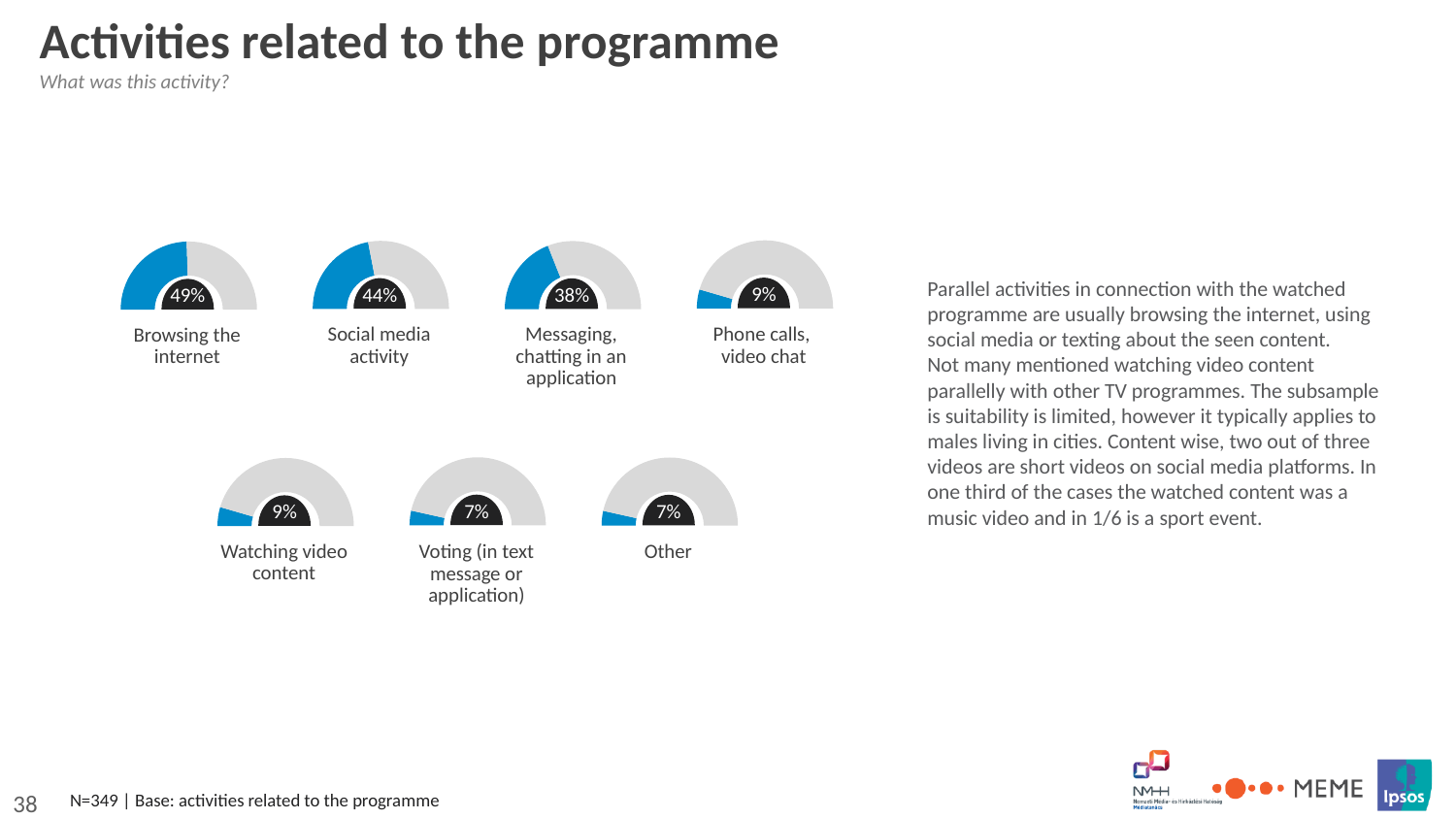
What is the difference in percentage points between Browsing the internet and Social media activity? 5 What colour is used for the filled portion of each gauge? Blue What percentage is shown for Messaging, chatting in an application? 38% What percentage is shown for Browsing the internet? 49% What kind of chart is used to show each activity's percentage? Gauge (semi-circular doughnut) chart What percentage is shown for Voting (in text message or application)? 7% Which activity has the highest percentage? Browsing the internet How many activities are shown on the slide? 7 Which is larger, the value for Messaging, chatting in an application or the value for Watching video content? Messaging, chatting in an application What percentage is shown for Phone calls, video chat? 9% What percentage is shown for Social media activity? 44% What is the difference in percentage points between Social media activity and Messaging, chatting in an application? 6